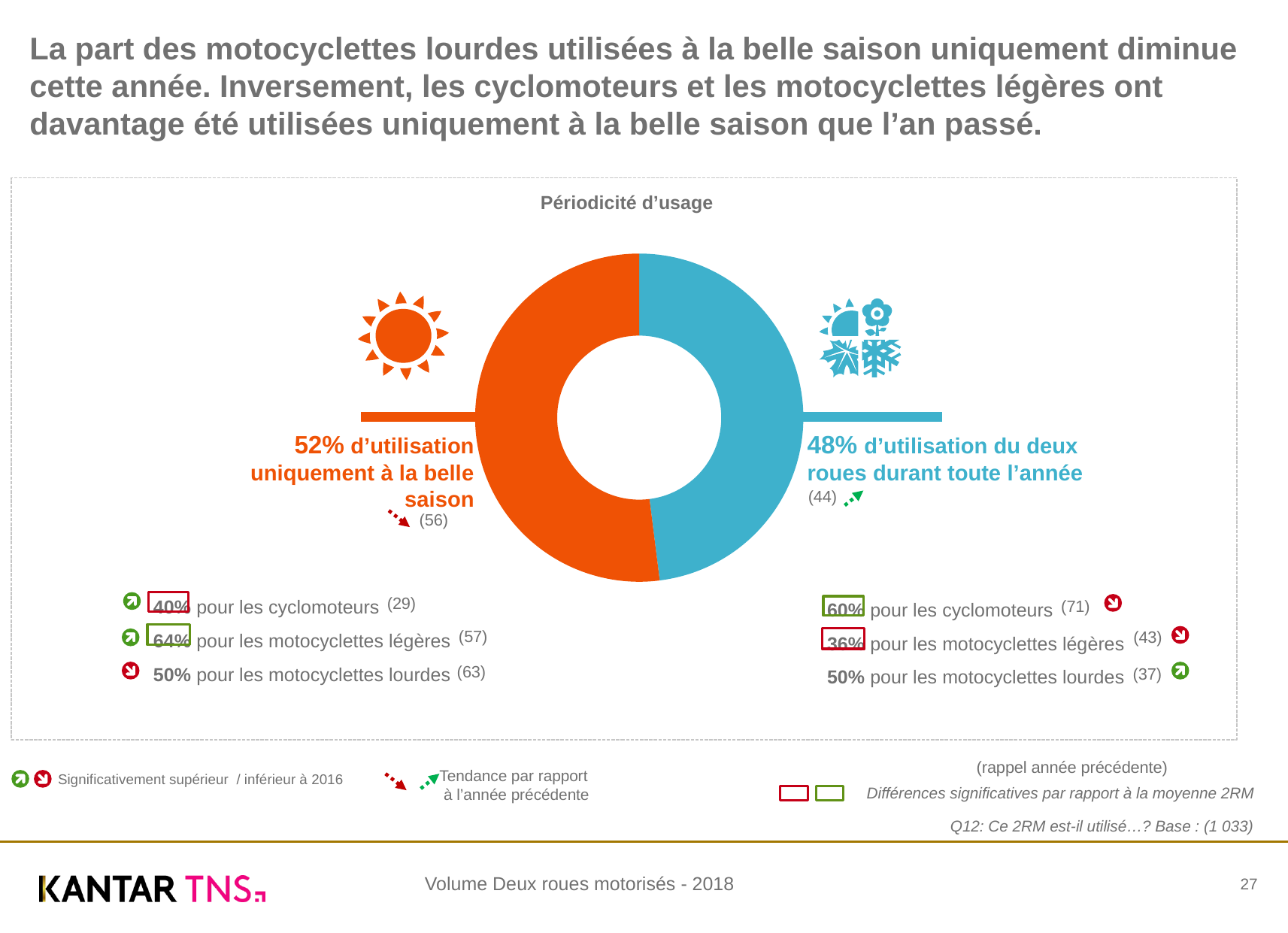
What share of the donut chart corresponds to use of the two-wheeler throughout the whole year? 48% What share of the donut chart corresponds to use only during the belle saison (fine season)? 52% Which slice of the donut chart is larger: use only in the belle saison or use throughout the whole year? Use only in the belle saison (52%) What is the title of the chart? Périodicité d'usage What was the previous year's value for use only during the belle saison, shown in parentheses? 56 What is the difference between the share for use only in the belle saison and the share for use throughout the year? 4 percentage points Which colour represents use throughout the whole year in the donut chart? Blue How many slices does the donut chart have? 2 What was the previous year's value for use throughout the whole year, shown in parentheses? 44 What percentage of cyclomoteurs (mopeds) are used only during the belle saison? 40% What kind of chart is shown on the slide? Donut (pie) chart What percentage of motocyclettes légères (light motorcycles) are used throughout the whole year? 36%